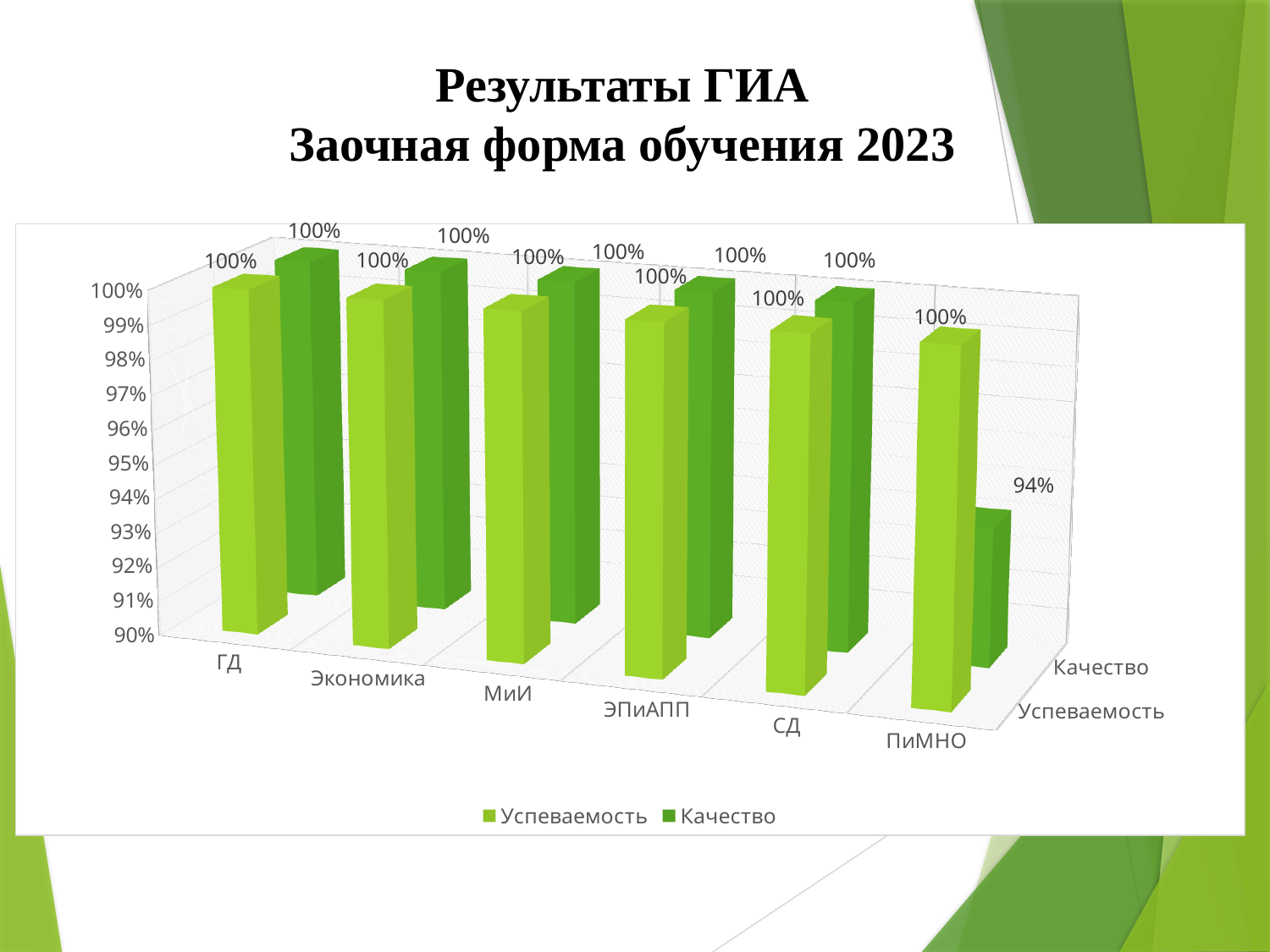
What is the Качество value for ГД? 100% What is the difference between the Успеваемость and Качество values for ПиМНО? 6% Is the Качество value for ПиМНО greater or less than 95%? less Which category has the lowest Качество value? ПиМНО How many series does the legend list? 2 What kind of chart is shown on the slide? bar chart What is the Успеваемость value for ПиМНО? 100% What is the Качество value for ПиМНО? 94% What is the title of the slide? Результаты ГИА Заочная форма обучения 2023 How many categories are shown on the chart? 6 What is the Успеваемость value for СД? 100% Which is larger for ПиМНО, Успеваемость or Качество? Успеваемость